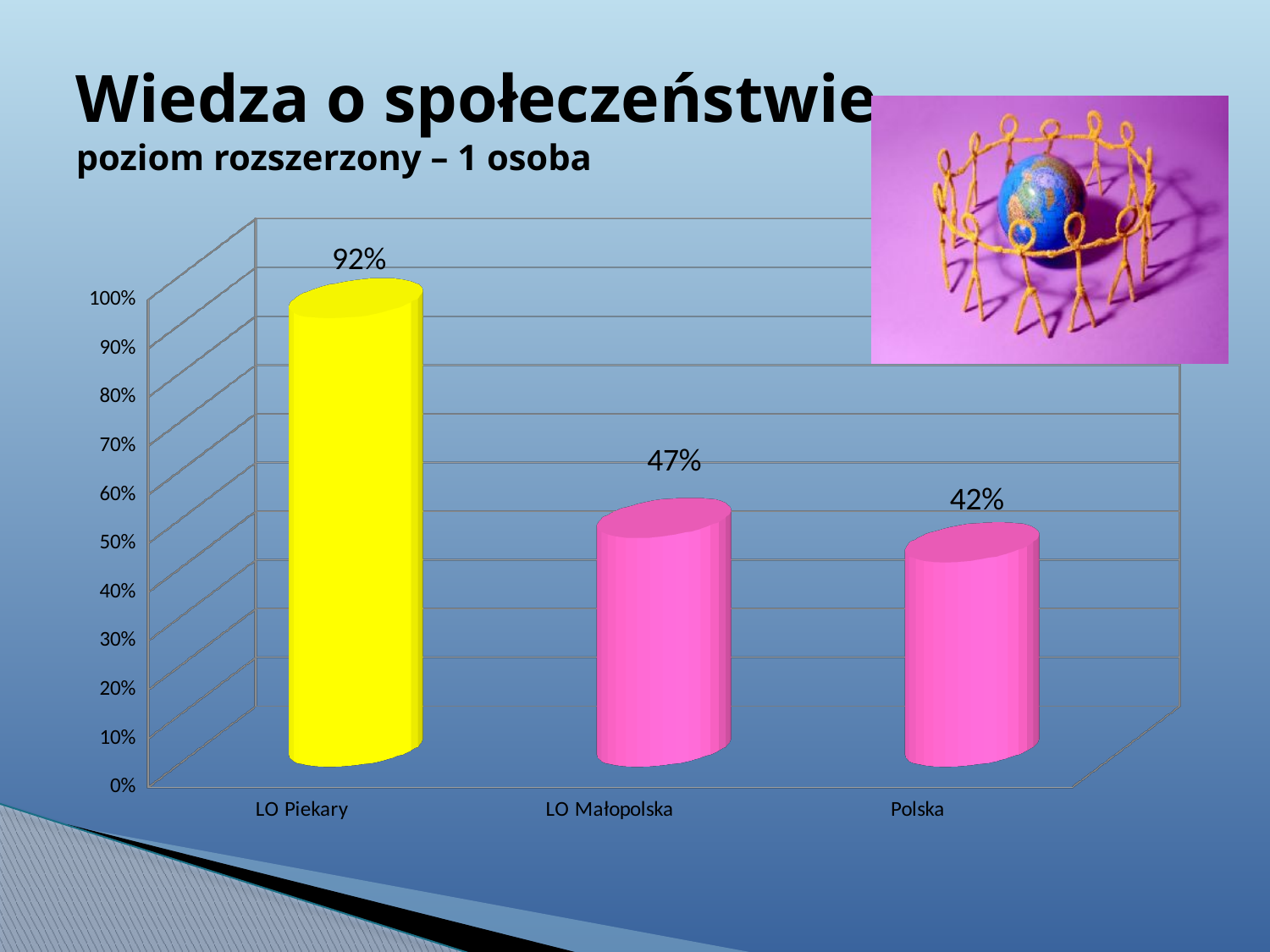
What is the value for LO Piekary? 92% How many categories are shown on the x axis? 3 Which category has the lowest value? Polska What is the difference between the values for LO Małopolska and Polska? 5% What kind of chart is shown on the slide? bar chart What colour is the bar for LO Piekary? yellow Is the value for LO Piekary greater or less than 80%? greater What is the difference between the values for LO Piekary and Polska? 50% Which category has the highest value? LO Piekary What is the value for Polska? 42% What is the value for LO Małopolska? 47% Which is larger, the value for LO Piekary or the value for LO Małopolska? LO Piekary